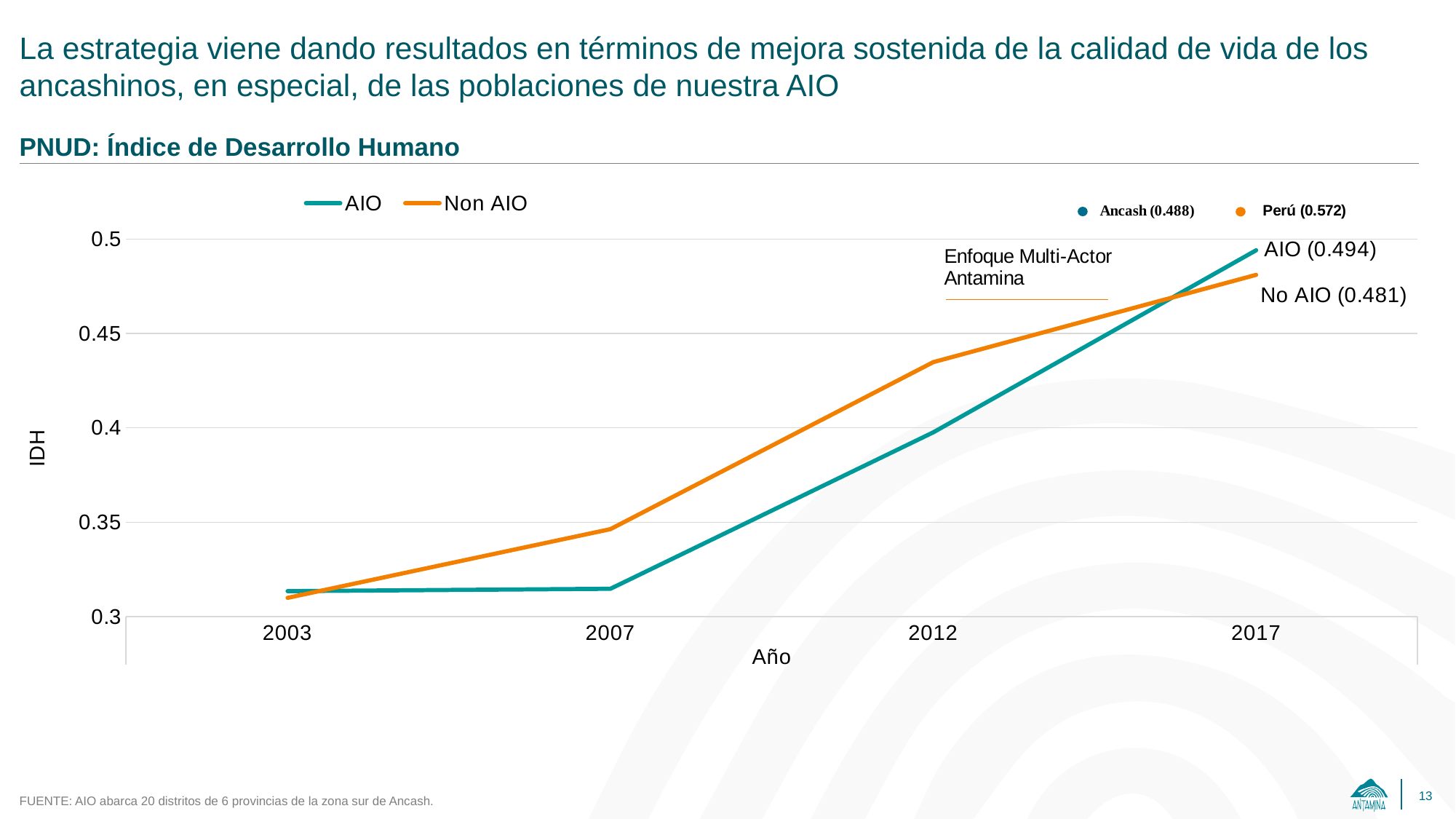
What is the difference between the AIO and Non AIO values in 2017? 0.013 Which series has the higher value in 2012, AIO or Non AIO? Non AIO Is the Non AIO value for 2012 greater or less than 0.4? greater What is the IDH value for Non AIO in 2017? 0.481 Is the AIO value for 2007 greater or less than 0.35? less What is the IDH value for AIO in 2017? 0.494 How many years are plotted along the x axis? 4 What type of chart is shown on the slide? line chart In which year does the AIO series reach its highest value? 2017 How many series does the chart legend list? 2 Which series has the higher value in 2017, AIO or Non AIO? AIO Does the AIO series rise or fall from 2007 to 2017? rise